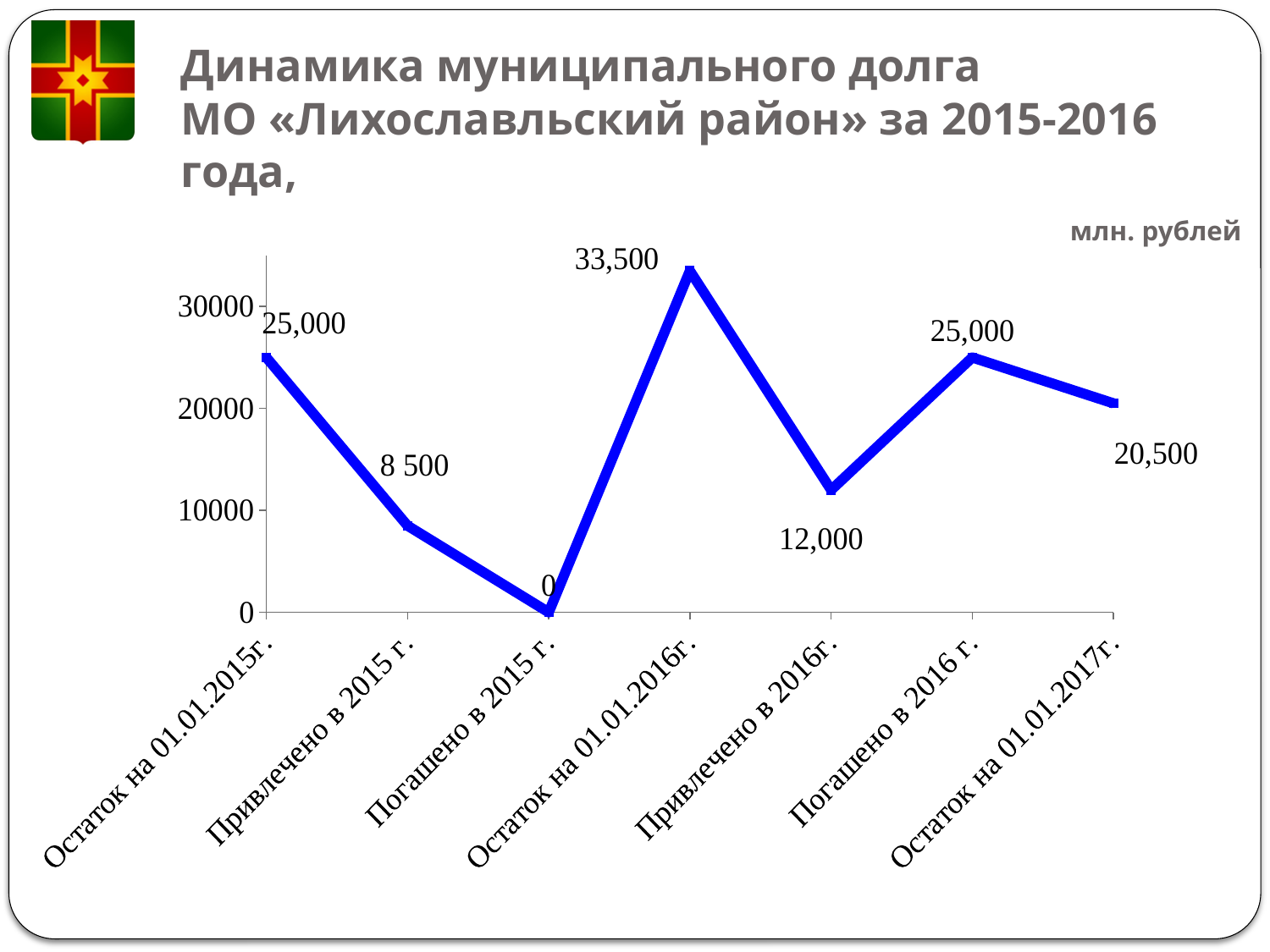
Which is larger: the value for «Привлечено в 2016г.» or the value for «Погашено в 2016 г.»? Погашено в 2016 г. What is the value for «Остаток на 01.01.2015г.»? 25,000 How many categories are plotted on the x axis? 7 Which category has the lowest value? Погашено в 2015 г. What is the value for «Привлечено в 2016г.»? 12,000 What kind of chart is shown on the slide? Line chart Which category has the highest value? Остаток на 01.01.2016г. What is the difference between the value for «Остаток на 01.01.2016г.» and the value for «Остаток на 01.01.2015г.»? 8,500 What unit is stated for the values on the chart? млн. рублей What is the value for «Привлечено в 2015 г.»? 8 500 What is the value for «Остаток на 01.01.2016г.»? 33,500 What is the value for «Остаток на 01.01.2017г.»? 20,500